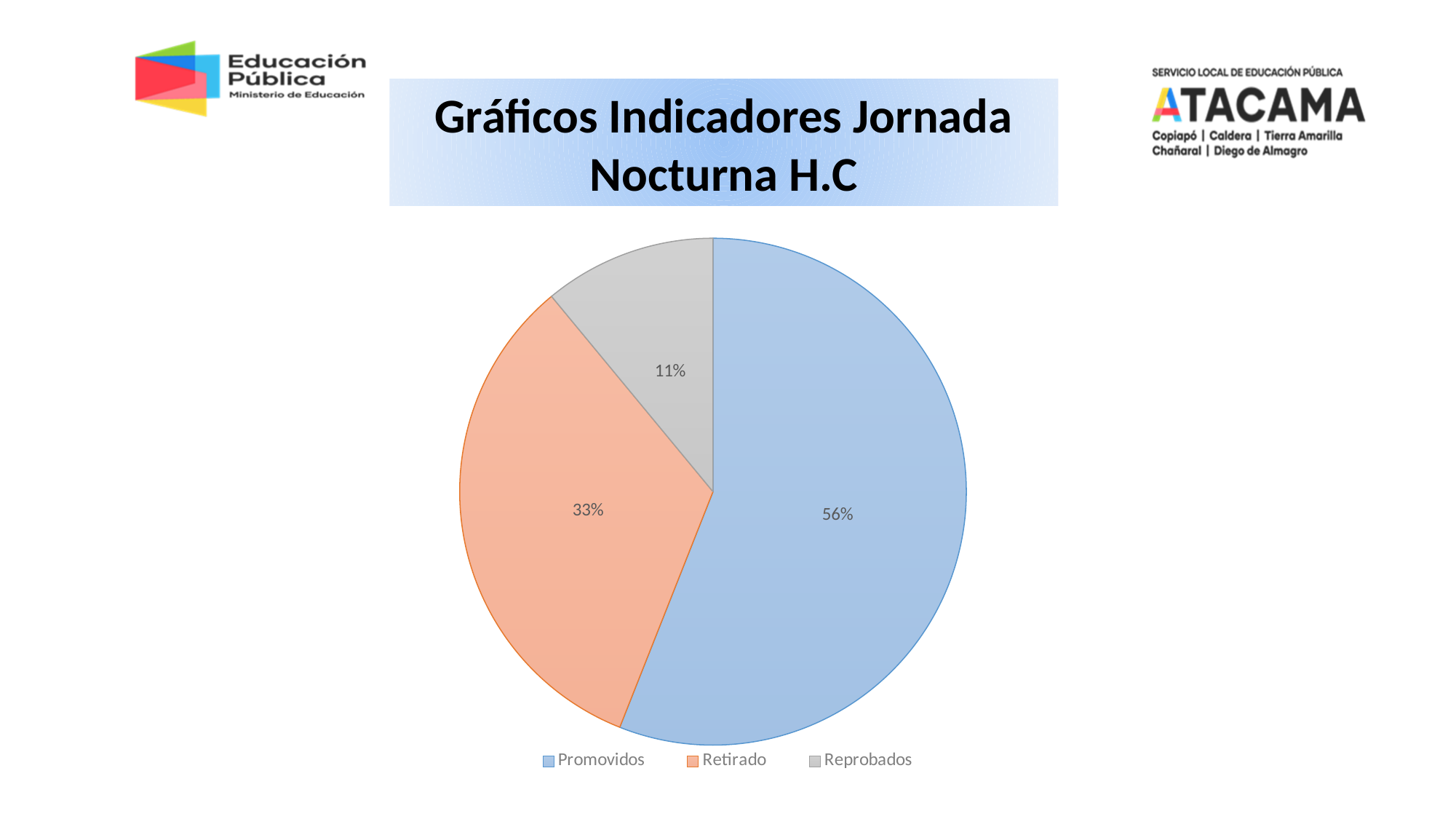
Which category has the largest slice of the pie? Promovidos Which category has the smallest slice of the pie? Reprobados How many categories does the pie chart show? 3 What colour is the Retirado slice in the pie chart? orange Which is larger, the share for Retirado or the share for Reprobados? Retirado What is the title of the slide containing the chart? Gráficos Indicadores Jornada Nocturna H.C What share of the pie does Retirado represent? 33% What share of the pie does Reprobados represent? 11% What kind of chart is shown on the slide? pie chart What is the difference in percentage points between Retirado and Reprobados? 22 What is the difference in percentage points between Promovidos and Retirado? 23 What share of the pie does Promovidos represent? 56%